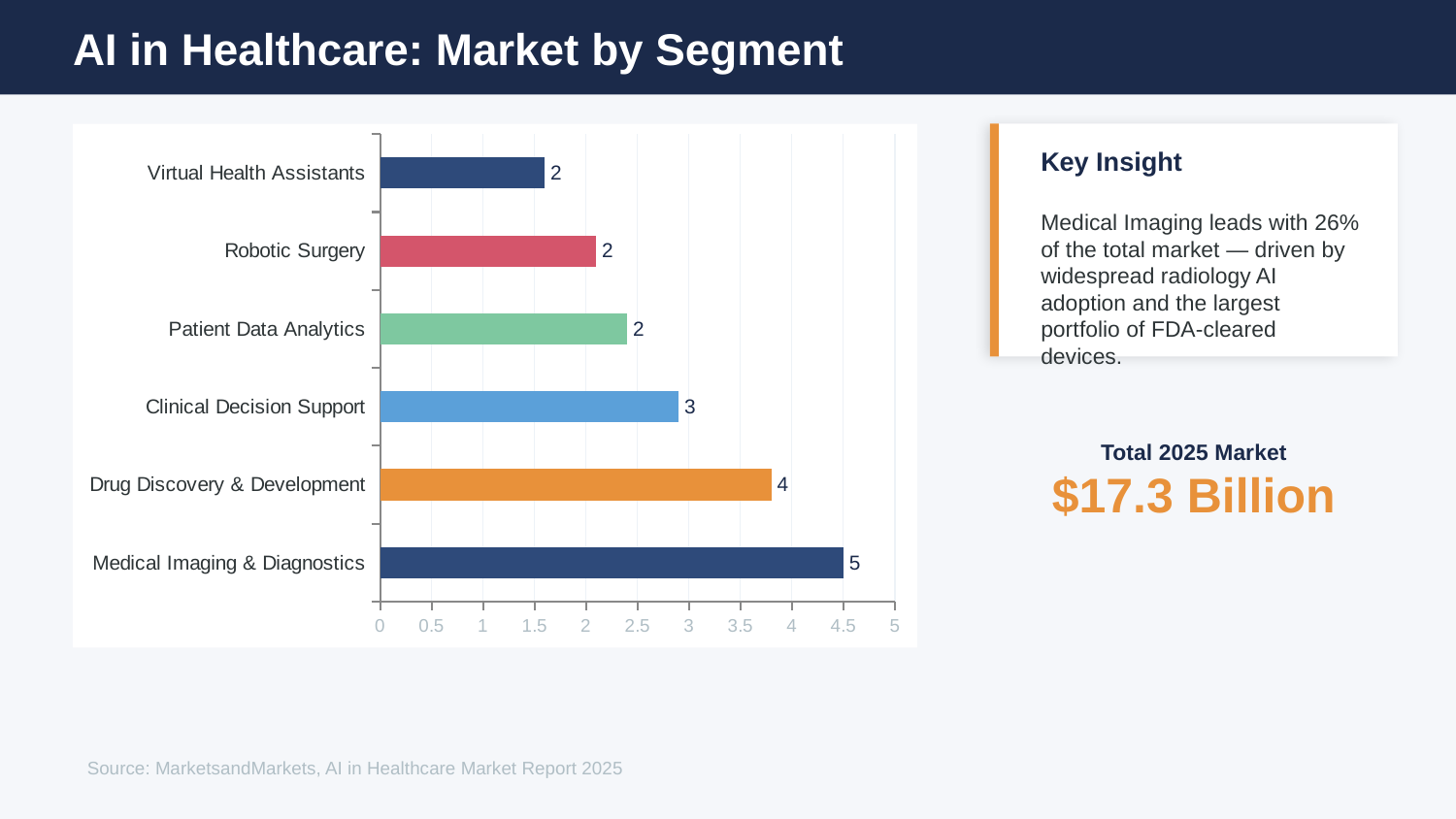
What is the value shown for Medical Imaging & Diagnostics? 5 What is the value shown for Drug Discovery & Development? 4 Which segment has the shortest bar in the chart? Virtual Health Assistants What is the value shown for Clinical Decision Support? 3 What is the difference between the labelled values for Medical Imaging & Diagnostics and Clinical Decision Support? 2 What is the value shown for Robotic Surgery? 2 Which is larger, the value for Drug Discovery & Development or the value for Clinical Decision Support? Drug Discovery & Development Is the bar for Drug Discovery & Development greater or less than 3.5? greater What kind of chart is shown on the slide? Bar chart Which segment has the highest value in the chart? Medical Imaging & Diagnostics How many segments are shown in the chart? 6